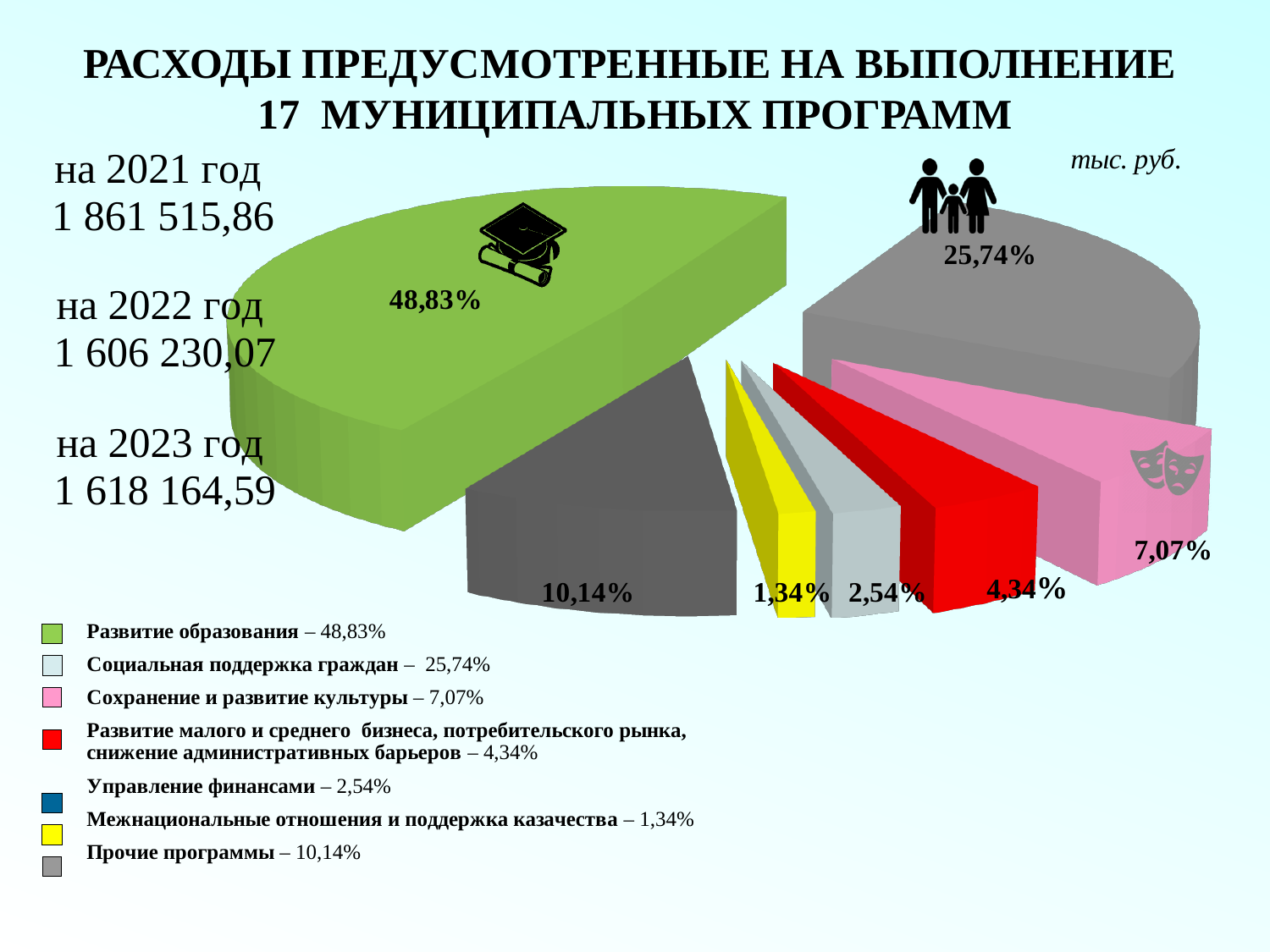
How many slices does the pie chart have? 7 Which category has the largest slice of the pie? Развитие образования What share of the pie does Сохранение и развитие культуры have? 7,07% What kind of chart is shown on the slide? pie chart What share of the pie does Развитие образования have? 48,83% Which category has the smallest slice of the pie? Межнациональные отношения и поддержка казачества What is the difference in percentage points between the shares for Развитие образования and Социальная поддержка граждан? 23,09 What share of the pie does Социальная поддержка граждан have? 25,74% Which is larger: the share for Прочие программы or the share for Сохранение и развитие культуры? Прочие программы What unit is indicated in the top right corner of the slide? тыс. руб. What share of the pie does Управление финансами have? 2,54% What share of the pie does Прочие программы have? 10,14%